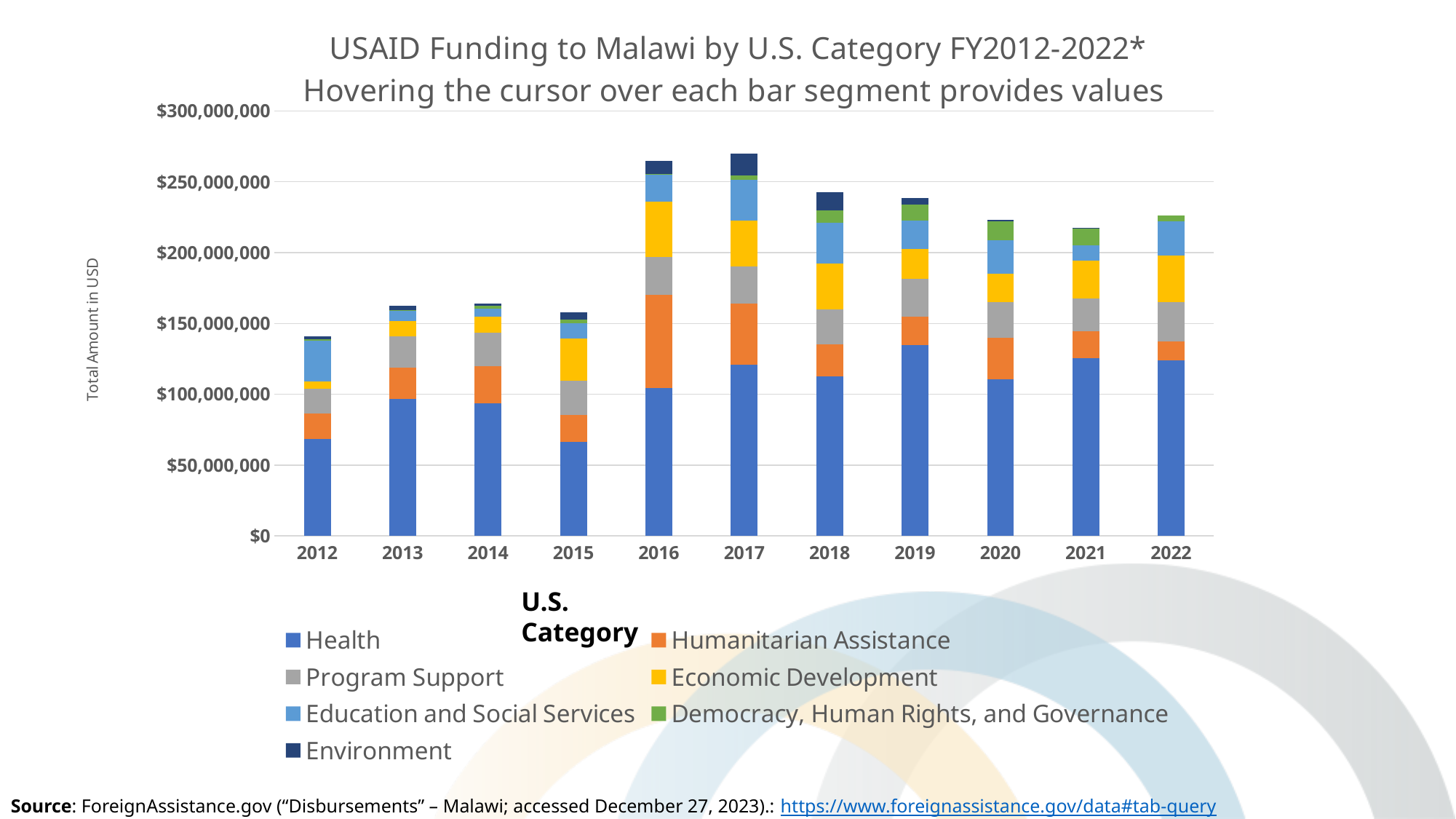
Is the Health segment for 2012 greater or less than $100,000,000? less Is the total funding for 2012 greater or less than $150,000,000? less Is the total funding for 2016 greater or less than $250,000,000? greater How many U.S. categories does the legend list? 7 Which year has the larger total funding, 2015 or 2016? 2016 Does total funding generally rise or fall from 2012 to 2017? rise How many fiscal years are shown along the x axis? 11 Which category is shown at the bottom of each stacked bar? Health What kind of chart is shown on the slide? Stacked bar chart Which year has the lowest total USAID funding to Malawi? 2012